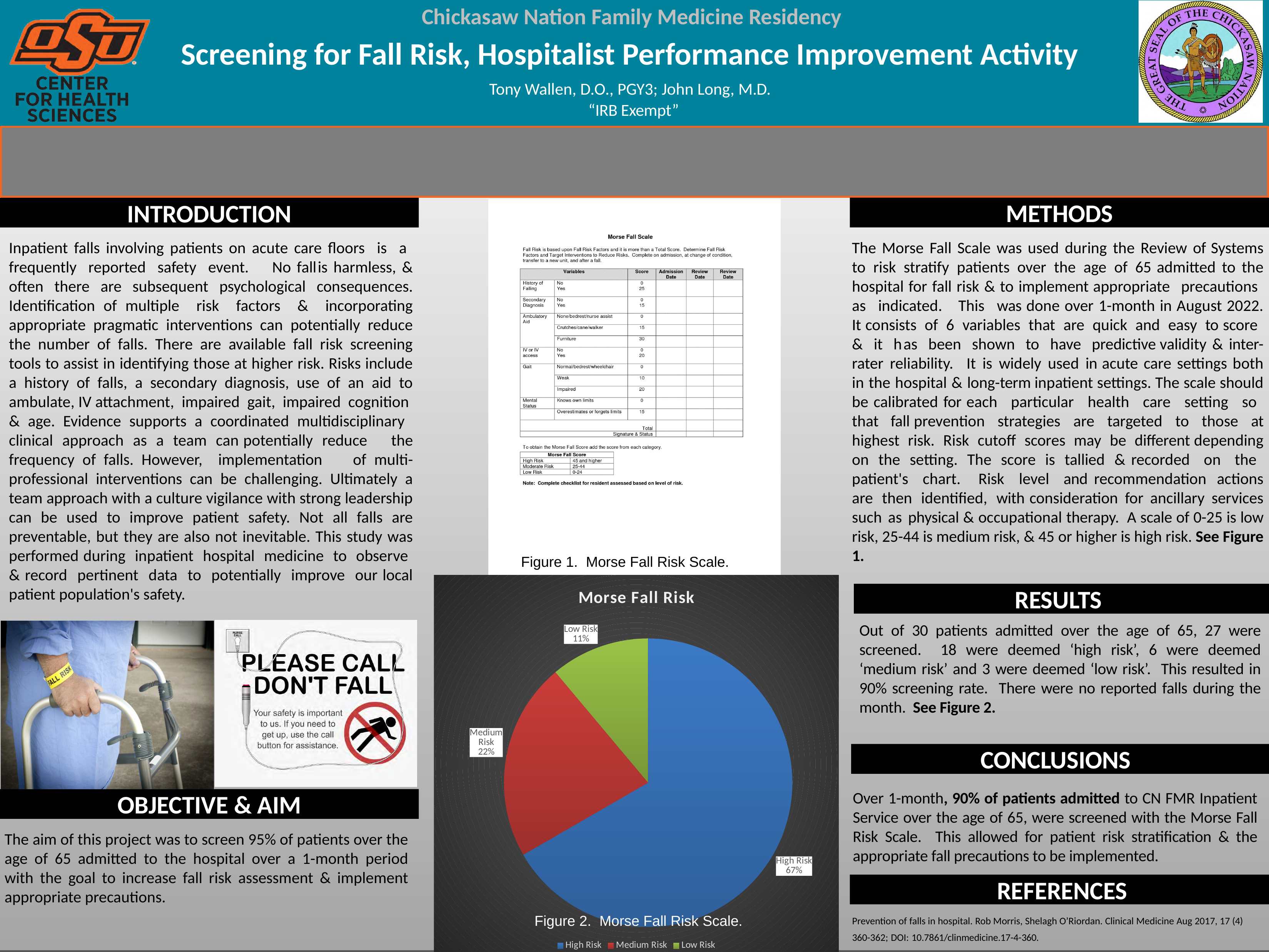
What colour is the High Risk slice in the pie chart? blue What is the title of the pie chart? Morse Fall Risk What kind of chart is the "Morse Fall Risk" chart? pie chart Which category has the smallest slice of the pie? Low Risk How many entries does the legend of the pie chart list? 3 What share of the pie does Low Risk represent? 11% Which category has the largest slice of the pie? High Risk Which slice is larger, Medium Risk or Low Risk? Medium Risk What share of the pie does High Risk represent? 67% What share of the pie does Medium Risk represent? 22% What is the difference in percentage points between the High Risk and Medium Risk slices? 45 How many slices does the pie chart have? 3